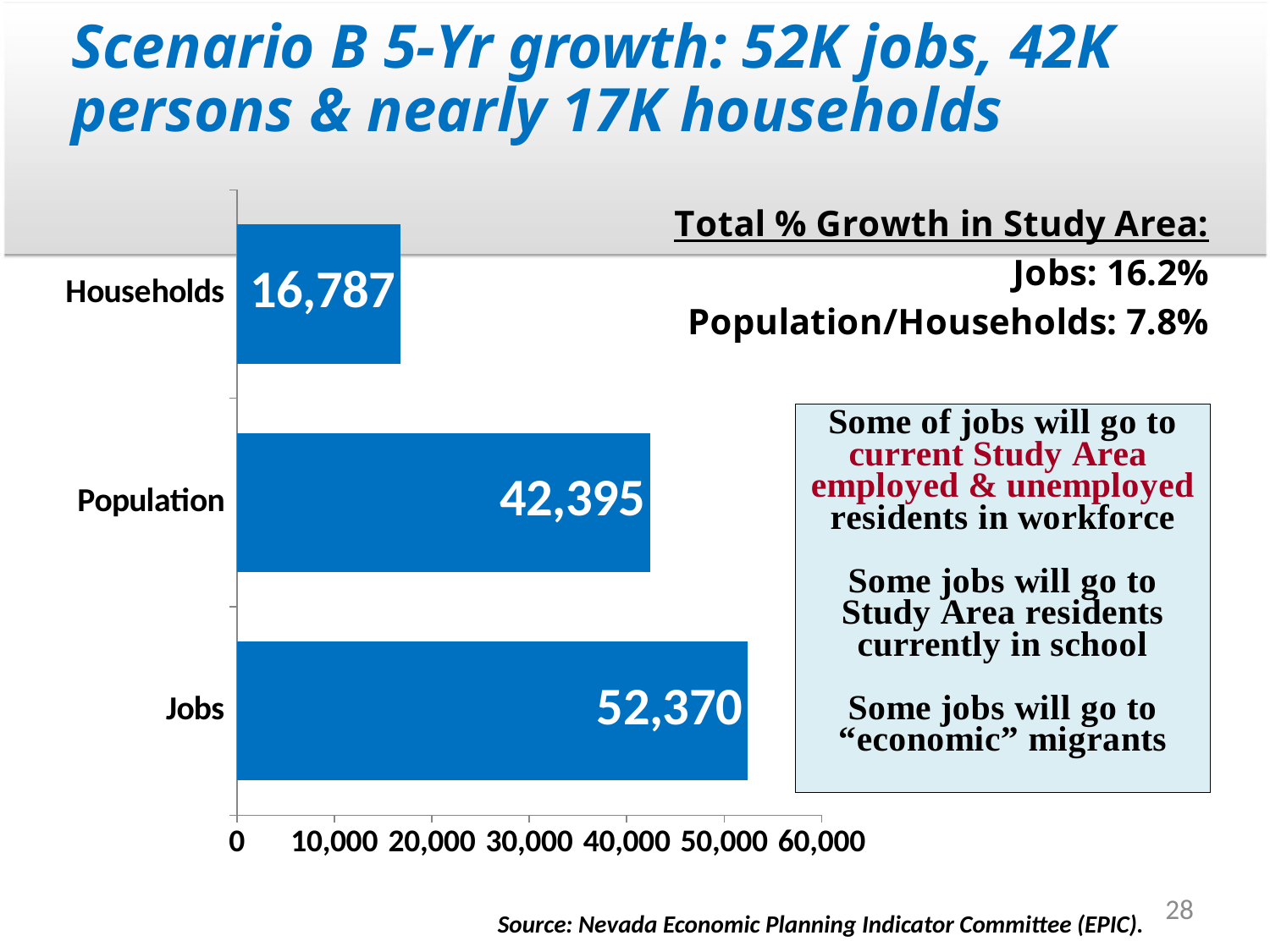
Which category has the lowest value? Households What is the difference between the Jobs value and the Population value? 9,975 What is the value for Households? 16,787 Which category has the highest value? Jobs How many categories are shown in the chart? 3 What is the difference between the Population value and the Households value? 25,608 What is the value for Jobs? 52,370 What kind of chart is shown on the slide? bar chart Which is larger, the value for Population or the value for Households? Population Is the value for Jobs greater or less than 50,000? greater What is the value for Population? 42,395 What is the highest value shown on the horizontal axis? 60,000